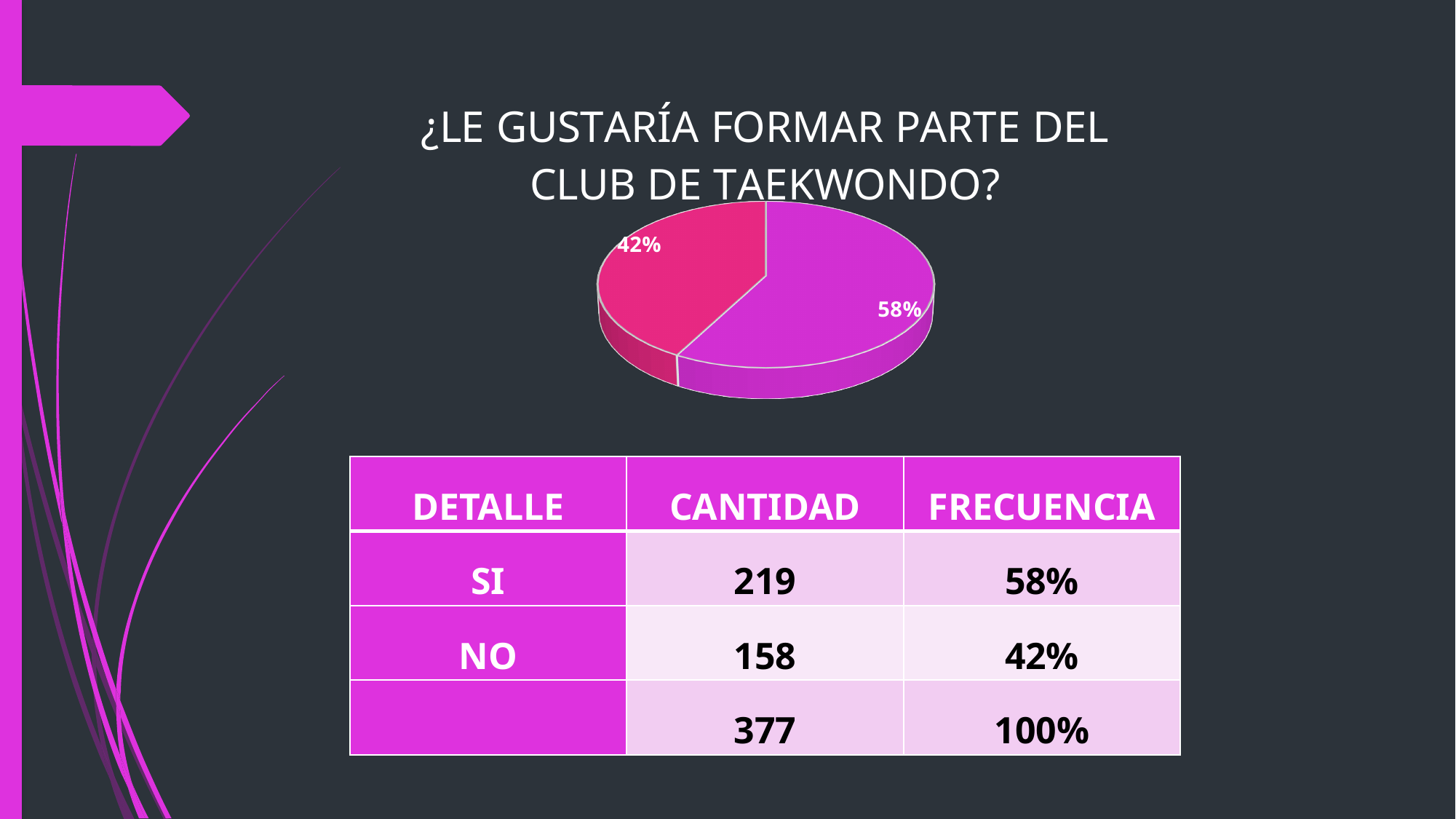
What kind of chart is shown on the slide? pie chart How many slices does the pie chart have? 2 Is the share of the larger slice greater or less than 50%? greater What percentage is shown on the smaller slice of the pie chart? 42% What is the difference in percentage points between the two slices of the pie chart? 16 What percentage is shown on the larger slice of the pie chart? 58% According to the table, what share of the pie corresponds to NO? 42% What is the title of the chart? ¿LE GUSTARÍA FORMAR PARTE DEL CLUB DE TAEKWONDO? What colour is the 42% slice of the pie chart? pink Which response has the larger slice in the pie chart, SI or NO? SI